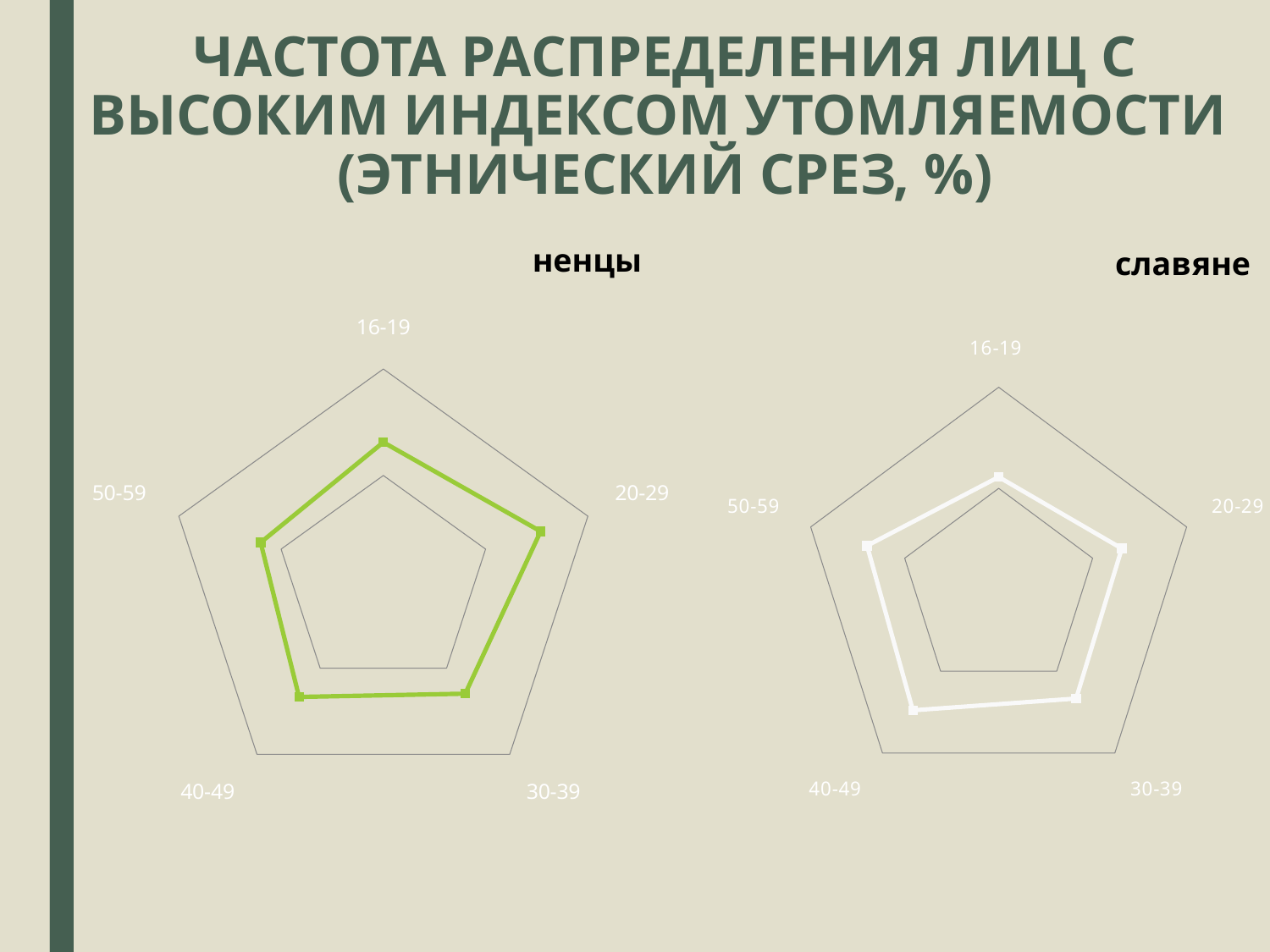
On the "славяне" chart, which is larger, the value for 16-19 or for 20-29? 20-29 How many age categories are plotted on the "ненцы" chart? 5 How many age categories are plotted on the "славяне" chart? 5 What kind of chart is the right chart titled "славяне"? radar chart What is the title of the left chart? ненцы On the "славяне" chart, which is larger, the value for 16-19 or for 40-49? 40-49 On the "ненцы" chart, which is larger, the value for 16-19 or for 20-29? 20-29 What kind of chart is the left chart titled "ненцы"? radar chart What colour is the data line on the "ненцы" chart? green On the "славяне" chart, which age category has the lowest value? 16-19